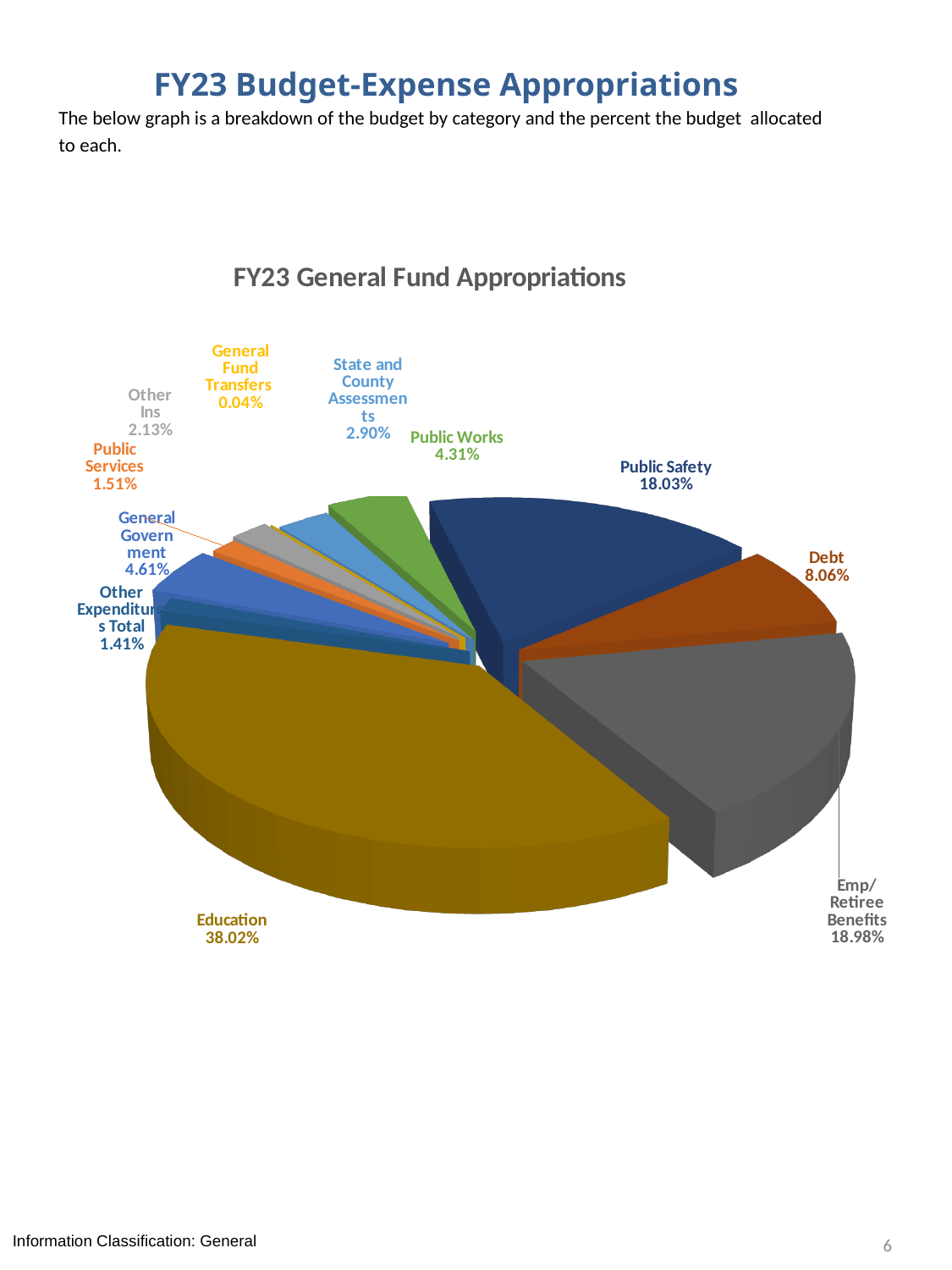
What percentage is allocated to Emp/Retiree Benefits? 18.98% What percentage is allocated to Debt? 8.06% How many categories are shown in the pie chart? 11 What percentage of the FY23 General Fund Appropriations goes to Education? 38.02% Which category has the largest share of the FY23 General Fund Appropriations? Education What percentage is allocated to General Fund Transfers? 0.04% Which is larger, the share for Public Works or the share for General Government? General Government What is the difference in percentage points between Education and Public Safety? 19.99 Which category has the smallest share of the FY23 General Fund Appropriations? General Fund Transfers What kind of chart is shown on the slide? Pie chart What is the title of the chart? FY23 General Fund Appropriations What percentage is allocated to Public Safety? 18.03%